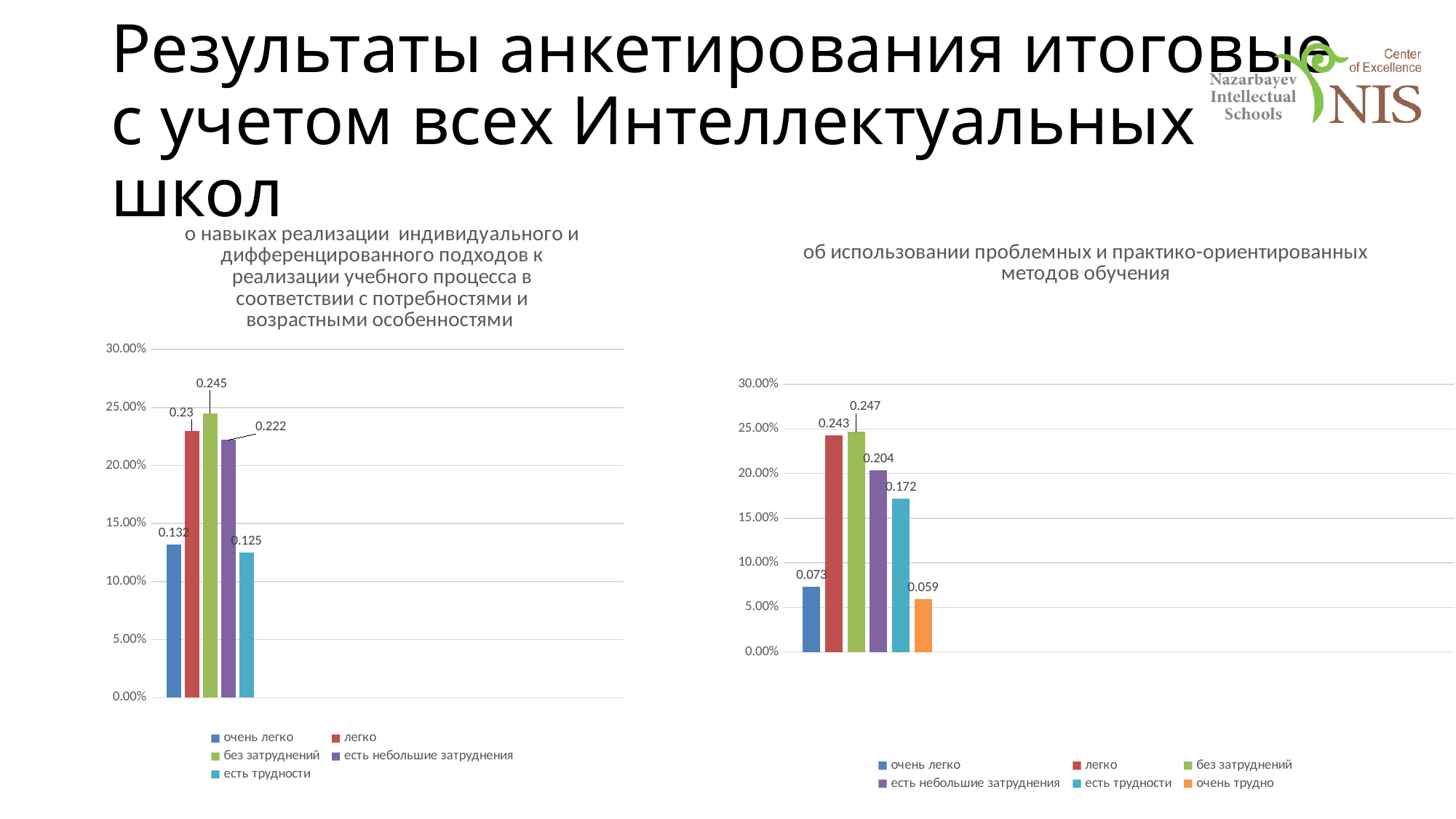
What type of chart is the right chart (об использовании проблемных и практико-ориентированных методов обучения)? bar chart In the left chart (о навыках реализации индивидуального и дифференцированного подходов), what is the value for 'очень легко'? 0.132 In the right chart (об использовании проблемных и практико-ориентированных методов обучения), which series has the lowest value? очень трудно How many series does the legend of the left chart (о навыках реализации индивидуального и дифференцированного подходов) list? 5 In the right chart (об использовании проблемных и практико-ориентированных методов обучения), which is larger: the value for 'очень легко' or the value for 'есть трудности'? есть трудности In the right chart (об использовании проблемных и практико-ориентированных методов обучения), what is the value for 'очень трудно'? 0.059 In the left chart (о навыках реализации индивидуального и дифференцированного подходов), which series has the lowest value? есть трудности In the left chart (о навыках реализации индивидуального и дифференцированного подходов), what is the value for 'есть небольшие затруднения'? 0.222 How many series does the legend of the right chart (об использовании проблемных и практико-ориентированных методов обучения) list? 6 In the right chart (об использовании проблемных и практико-ориентированных методов обучения), what is the value for 'есть трудности'? 0.172 In the left chart (о навыках реализации индивидуального и дифференцированного подходов), which series has the highest value? без затруднений In the left chart (о навыках реализации индивидуального и дифференцированного подходов), what is the difference between the values for 'без затруднений' and 'легко'? 0.015